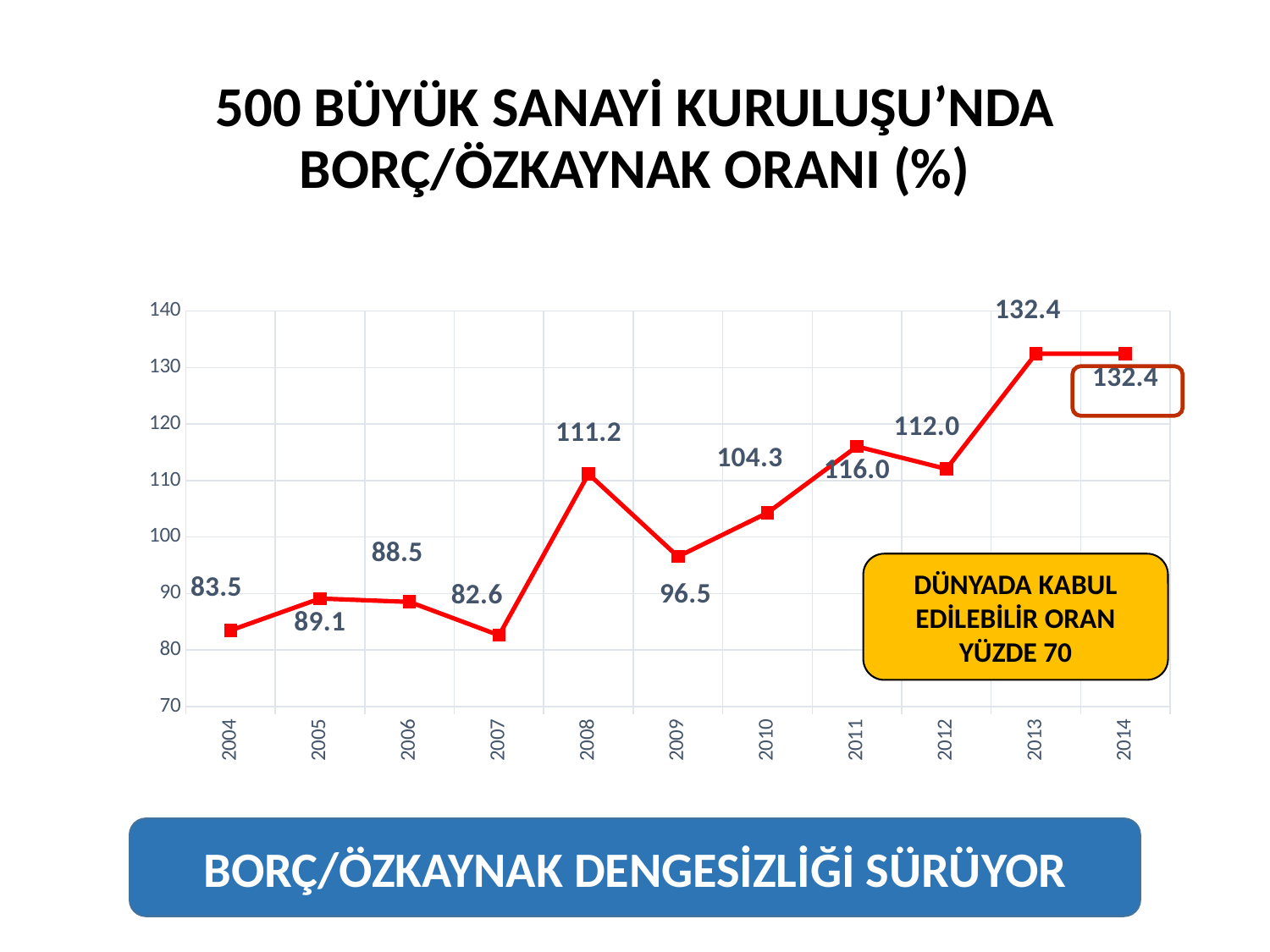
How many years are plotted on the x axis? 11 What is the value plotted for 2011? 116.0 According to the yellow box, what is the globally acceptable ratio? Yüzde 70 What is the difference between the values for 2013 and 2012? 20.4 What is the debt/equity ratio value for 2008? 111.2 What is the highest value shown on the chart? 132.4 What value is shown for 2014? 132.4 Which year has the larger value, 2009 or 2010? 2010 What kind of chart is shown on the slide? Line chart Which year has the lowest value on the chart? 2007 Is the value for 2012 greater or less than 110? greater What value is shown for 2004? 83.5